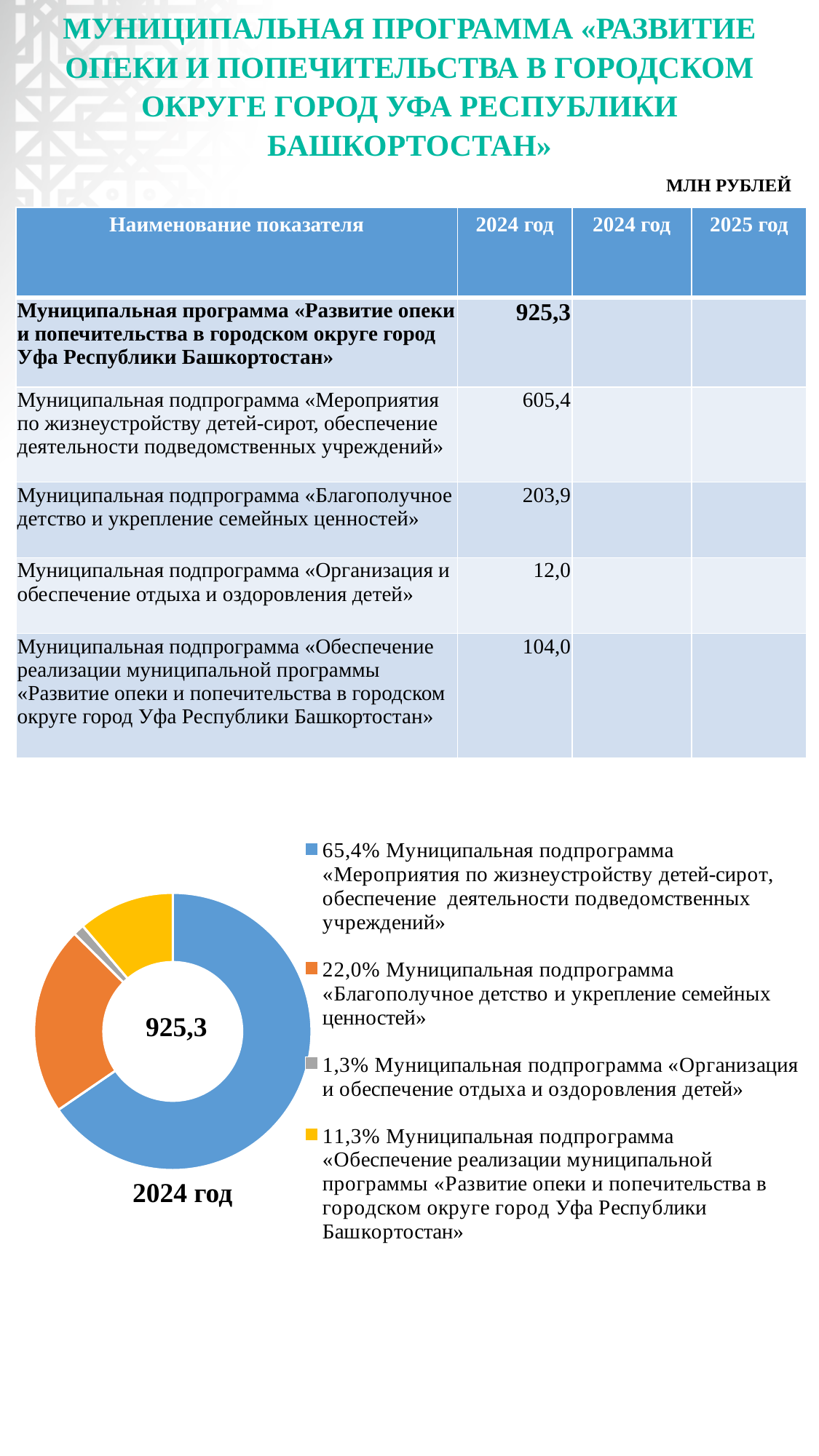
What share of the doughnut chart does the subprogram «Организация и обеспечение отдыха и оздоровления детей» have? 1,3% How many slices does the doughnut chart have? 4 What share of the doughnut chart does the subprogram «Мероприятия по жизнеустройству детей-сирот, обеспечение деятельности подведомственных учреждений» have? 65,4% What value is printed in the centre of the doughnut chart? 925,3 What year label is shown under the doughnut chart? 2024 год Which subprogram has the smallest share in the doughnut chart? Муниципальная подпрограмма «Организация и обеспечение отдыха и оздоровления детей» What kind of chart is shown at the bottom of the slide? doughnut chart Which subprogram has the largest share in the doughnut chart? Муниципальная подпрограмма «Мероприятия по жизнеустройству детей-сирот, обеспечение деятельности подведомственных учреждений» What share of the doughnut chart does the subprogram «Обеспечение реализации муниципальной программы «Развитие опеки и попечительства в городском округе город Уфа Республики Башкортостан»» have? 11,3% What share of the doughnut chart does the subprogram «Благополучное детство и укрепление семейных ценностей» have? 22,0% In the doughnut chart, what is the difference in percentage points between the share of «Мероприятия по жизнеустройству детей-сирот...» and the share of «Благополучное детство и укрепление семейных ценностей»? 43,4 In the doughnut chart, which has the larger share: «Благополучное детство и укрепление семейных ценностей» or «Обеспечение реализации муниципальной программы...»? «Благополучное детство и укрепление семейных ценностей»